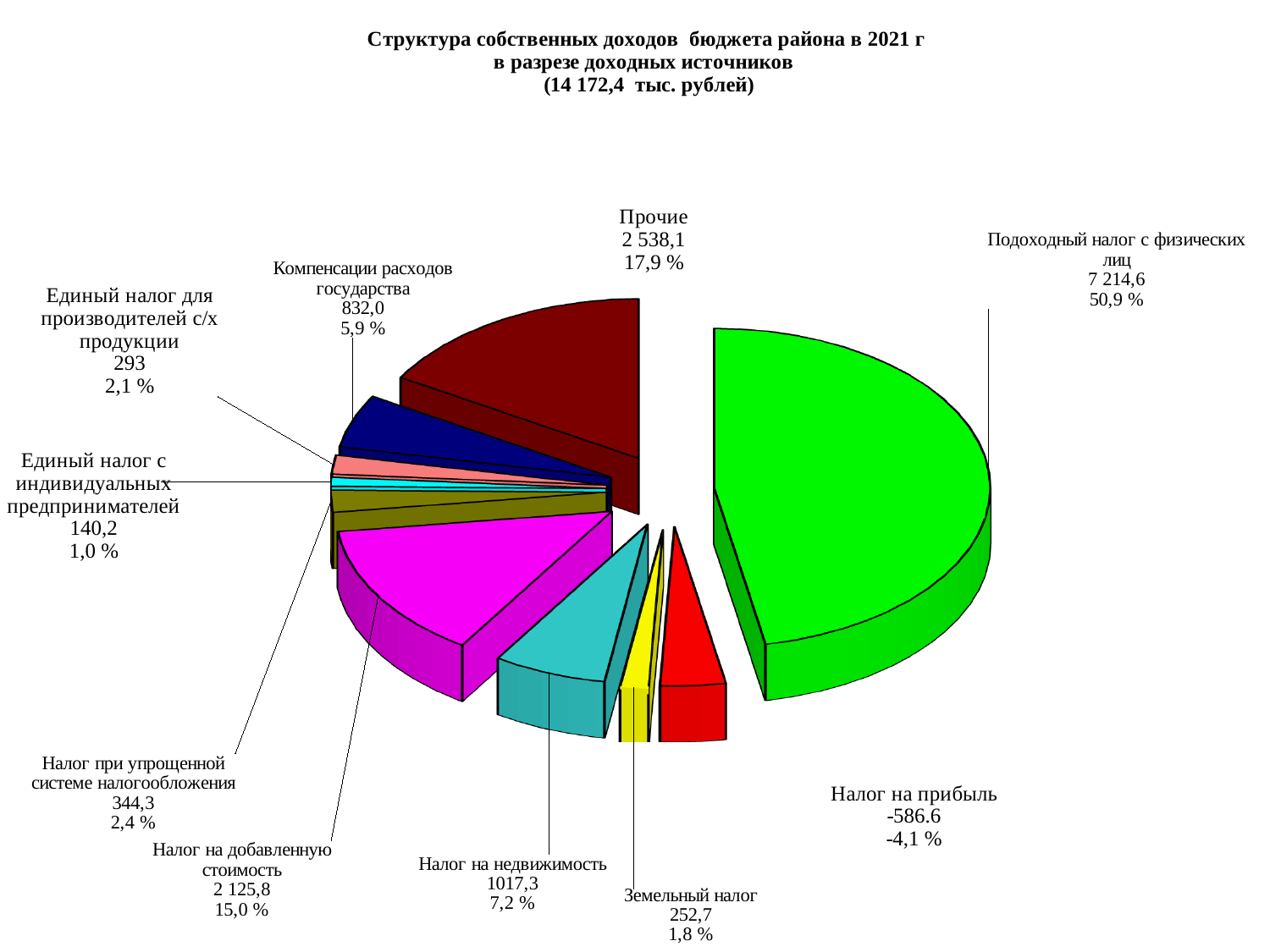
What is the value for Налог на недвижимость? 1017,3 Which category has the largest value? Подоходный налог с физических лиц What is the difference between the values for Подоходный налог с физических лиц and Прочие? 4 676,5 What total amount in тыс. рублей is stated in the chart title? 14 172,4 What share of the pie does Прочие represent? 17,9 % Which is larger, the value for Земельный налог or the value for Единый налог для производителей с/х продукции? Единый налог для производителей с/х продукции What kind of chart is shown on the slide? pie chart What is the value for Подоходный налог с физических лиц? 7 214,6 What share of the pie does Налог на добавленную стоимость represent? 15,0 % How many categories are labeled on the chart? 10 Which category has the lowest value? Налог на прибыль What is the value for Налог на прибыль? -586.6